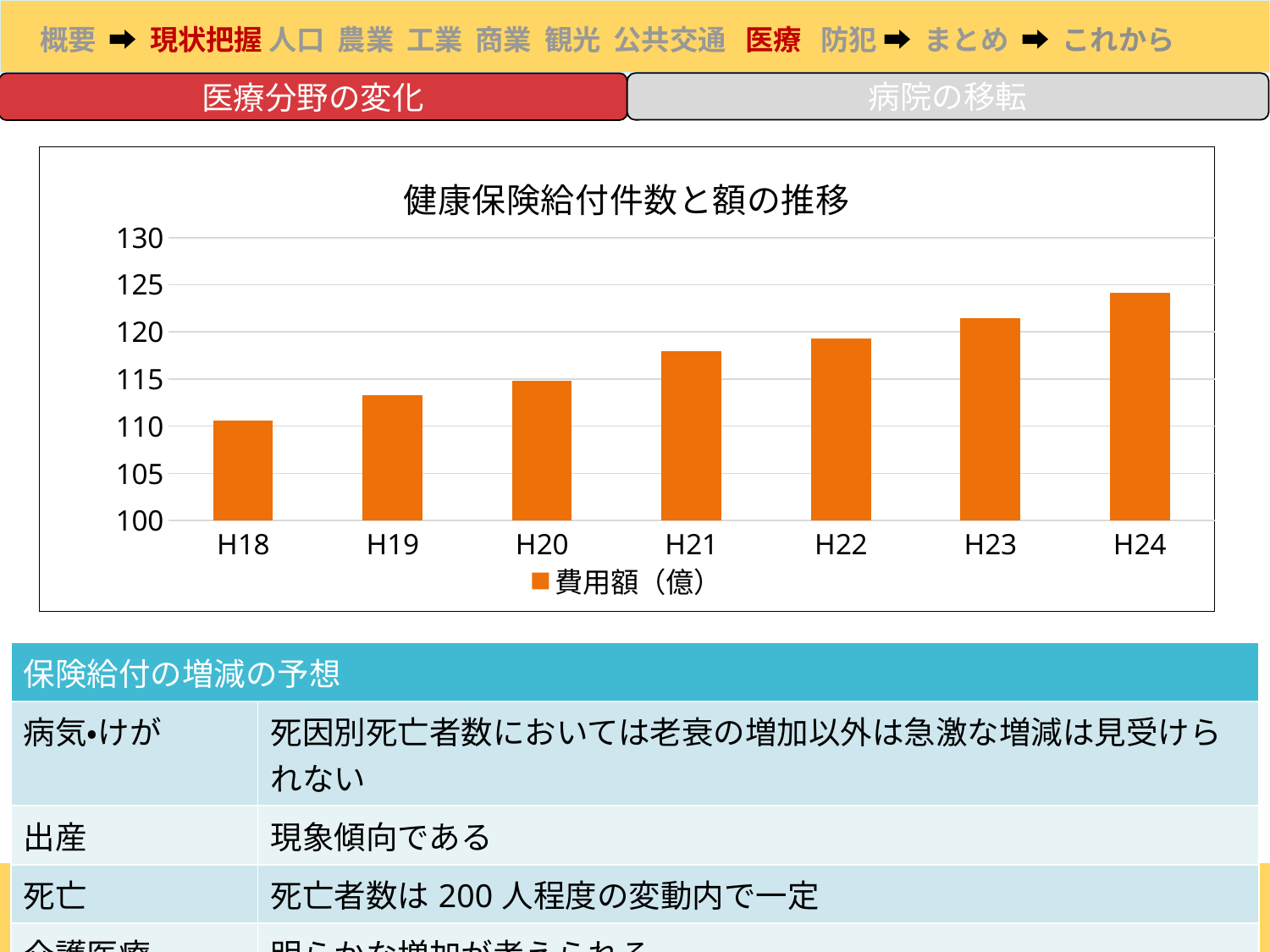
Which year has the highest value in the chart? H24 What is the title of the chart? 健康保険給付件数と額の推移 Is the value for H19 greater or less than 115? less Is the value for H23 greater or less than 120? greater What kind of chart is shown on the slide? bar chart How many categories (years) are shown on the x axis of the chart? 7 Which is larger, the value for H24 or the value for H18? H24 What is the name of the series shown in the chart's legend? 費用額（億） Is the value for H21 greater or less than 115? greater Which year has the lowest value in the chart? H18 How many series does the chart's legend list? 1 Do the values rise or fall from H18 to H24 along the x axis? rise